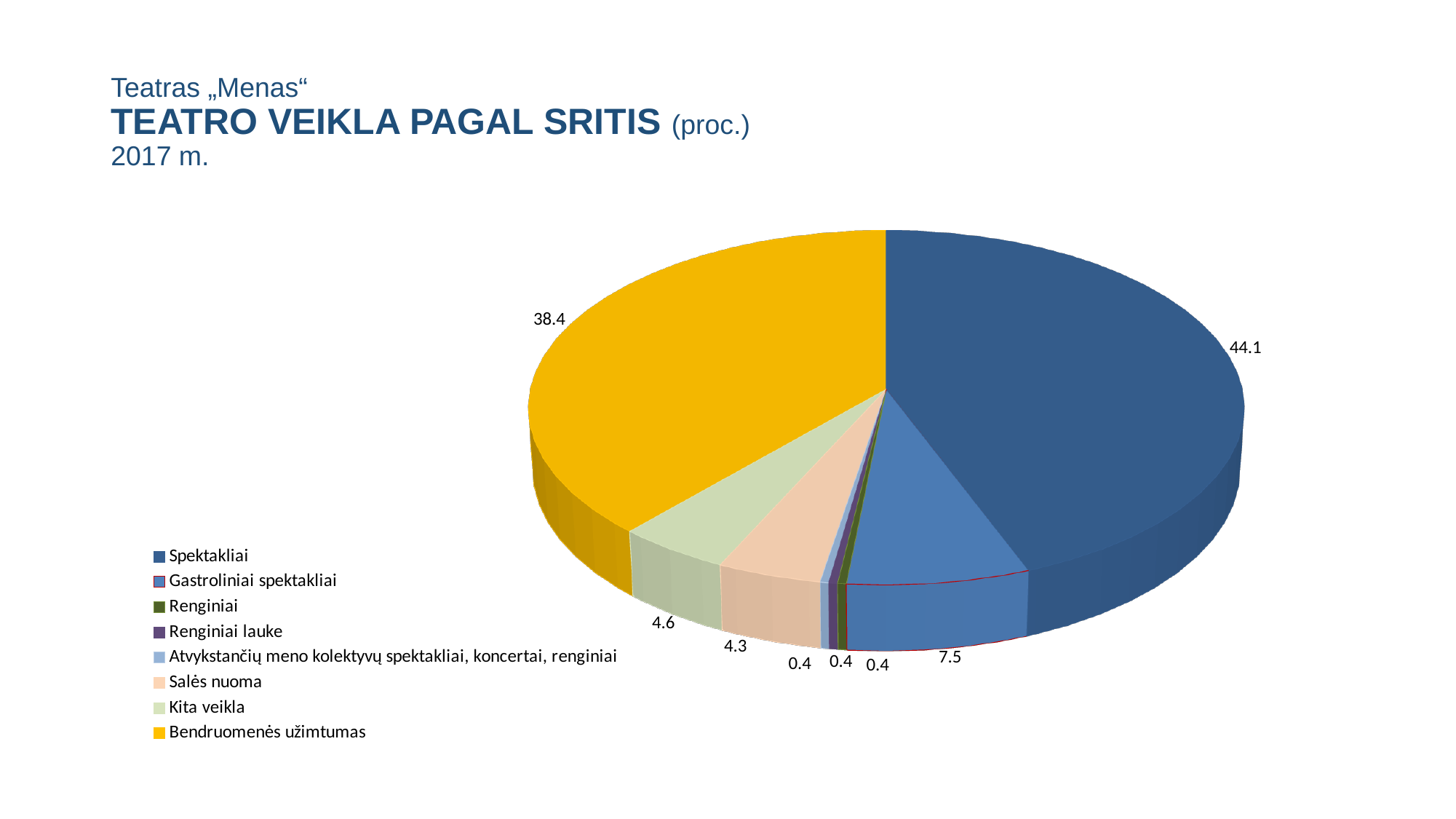
Which is larger, Kita veikla or Salės nuoma? Kita veikla What is the value for Bendruomenės užimtumas? 38.4 What is the value for Spektakliai? 44.1 What is the value for Salės nuoma? 4.3 How many categories does the legend list? 8 Which category has the largest share of the pie? Spektakliai What is the difference between the values for Gastroliniai spektakliai and Kita veikla? 2.9 What is the difference between the values for Spektakliai and Bendruomenės užimtumas? 5.7 What is the value for Kita veikla? 4.6 What kind of chart is shown on the slide? pie chart What is the value for Gastroliniai spektakliai? 7.5 What colour is the Bendruomenės užimtumas slice? yellow